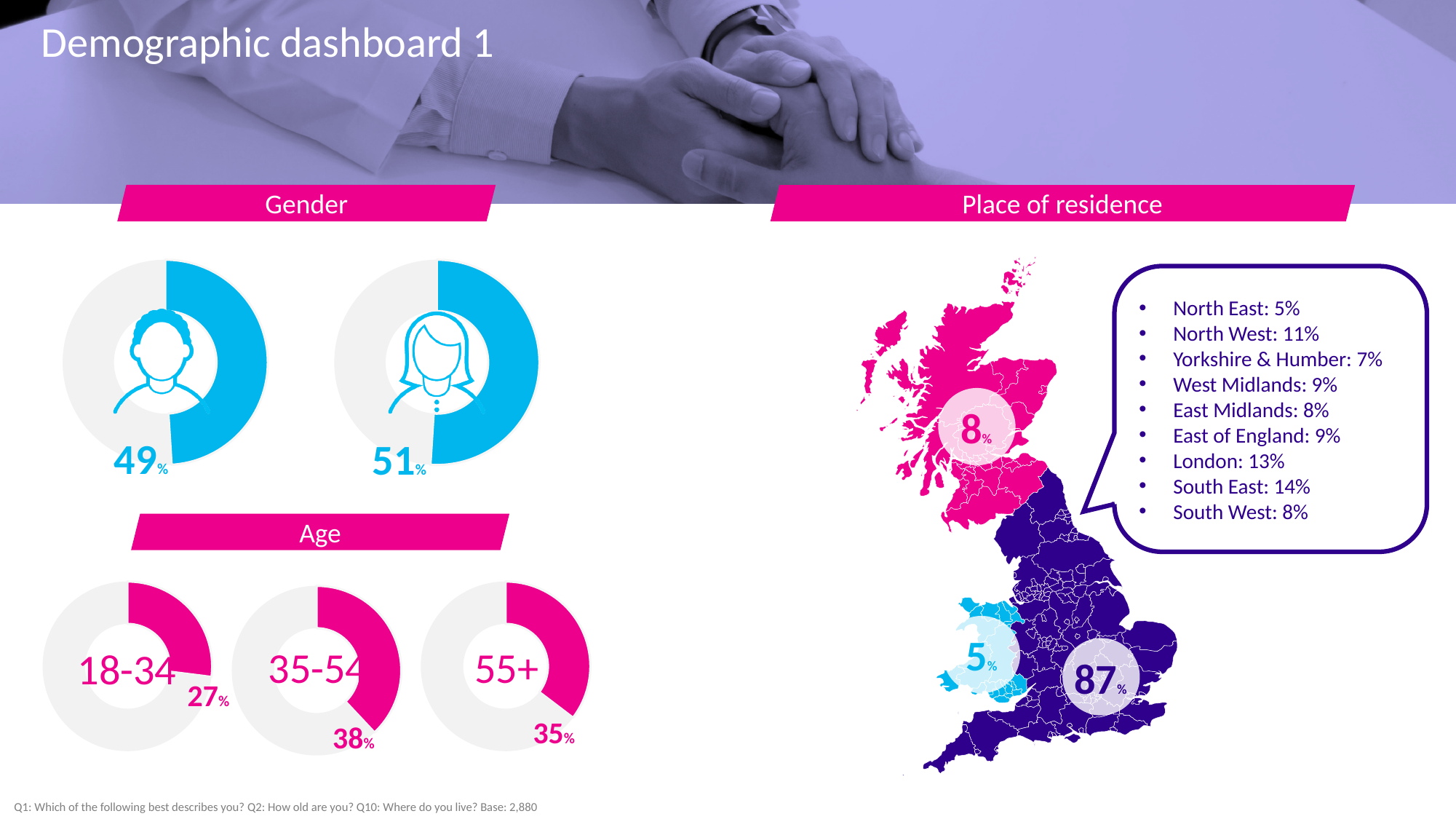
In the Age section, how many age groups are shown? 3 In the Place of residence map, what percentage is shown for England? 87% In the Age section, which age group has the highest percentage? 35-54 In the Place of residence list, which English region has the highest percentage? South East (14%) In the Gender section, which is larger, the male share or the female share? female (51%) In the Age section, which age group has the lowest percentage? 18-34 In the Age section, what percentage is shown for the 18-34 group? 27% In the Age section, what percentage is shown for the 35-54 group? 38% In the Gender section, what percentage is shown for the female donut chart? 51% In the Age section, what is the difference between the 35-54 and 55+ percentages? 3 percentage points In the Gender section, what percentage is shown for the male donut chart? 49% In the Place of residence map, what percentage is shown for Wales? 5%